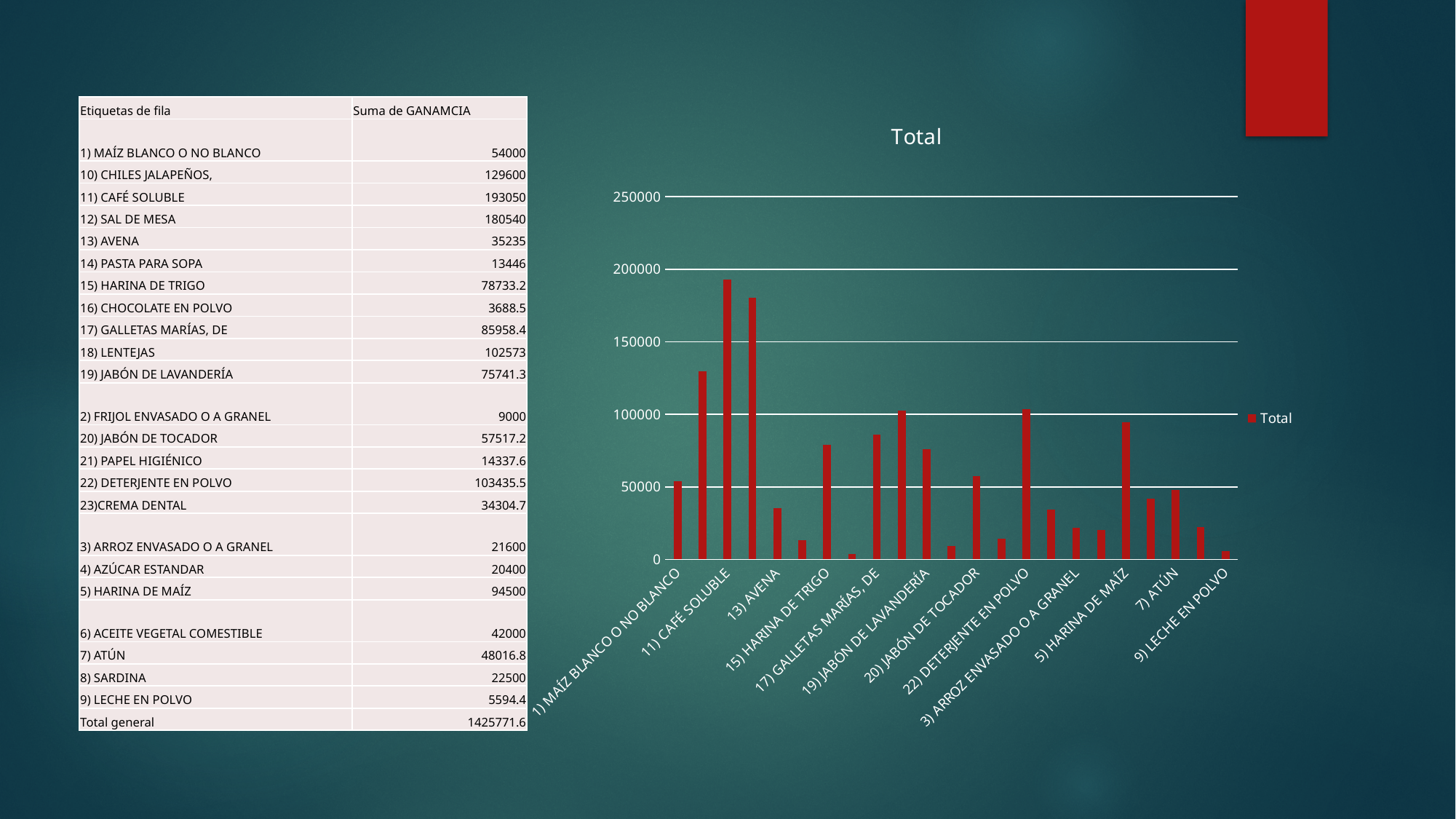
How many series does the chart legend list? 1 Which category has the tallest bar in the chart? 11) CAFÉ SOLUBLE Is the bar for 13) AVENA greater or less than 50000? less Is the bar for 9) LECHE EN POLVO greater or less than 50000? less How many bars are plotted in the chart? 23 According to the table on the slide, what is the Suma de GANAMCIA for 11) CAFÉ SOLUBLE? 193050 What kind of chart is shown on the slide? bar chart What is the title of the chart? Total Which bar is taller, 15) HARINA DE TRIGO or 7) ATÚN? 15) HARINA DE TRIGO Is the bar for 15) HARINA DE TRIGO greater or less than 50000? greater Which bar is taller, 11) CAFÉ SOLUBLE or 13) AVENA? 11) CAFÉ SOLUBLE